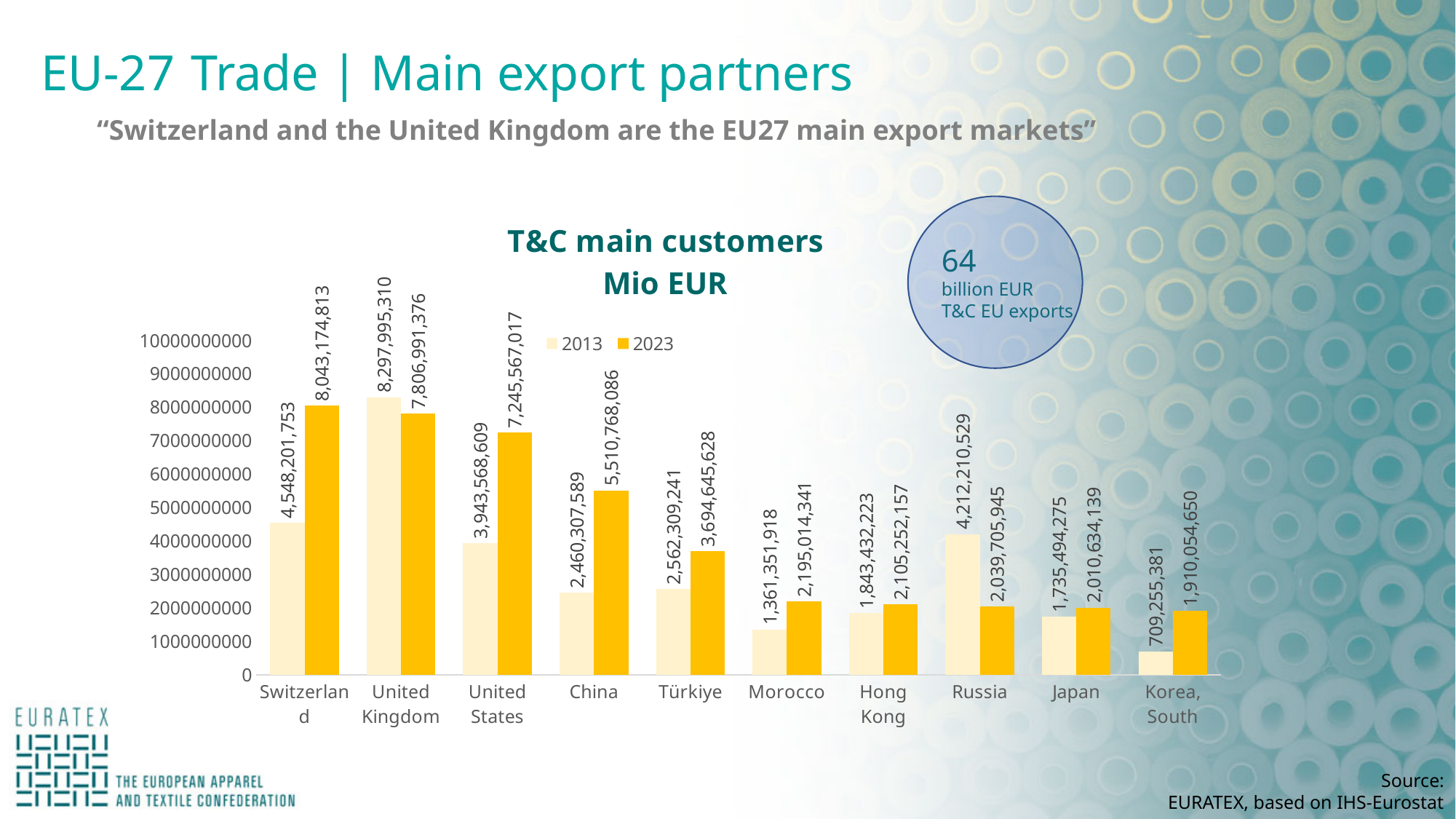
What is the 2013 value for Russia in the T&C main customers chart? 4,212,210,529 What is the 2023 value for Switzerland in the T&C main customers chart? 8,043,174,813 What is the 2023 value for Korea, South? 1,910,054,650 By how much did Switzerland's value increase from 2013 to 2023? 3,494,973,060 How many series does the chart legend list? 2 For the United Kingdom, which is larger: the 2013 value or the 2023 value? 2013 Which country has the highest 2013 value in the chart? United Kingdom Which country has the highest 2023 value in the chart? Switzerland Which country has the lowest 2013 value in the chart? Korea, South What type of chart is used to show the T&C main customers? Bar chart How many countries are shown on the x axis of the chart? 10 What is the difference between Russia's 2013 and 2023 values? 2,172,504,584